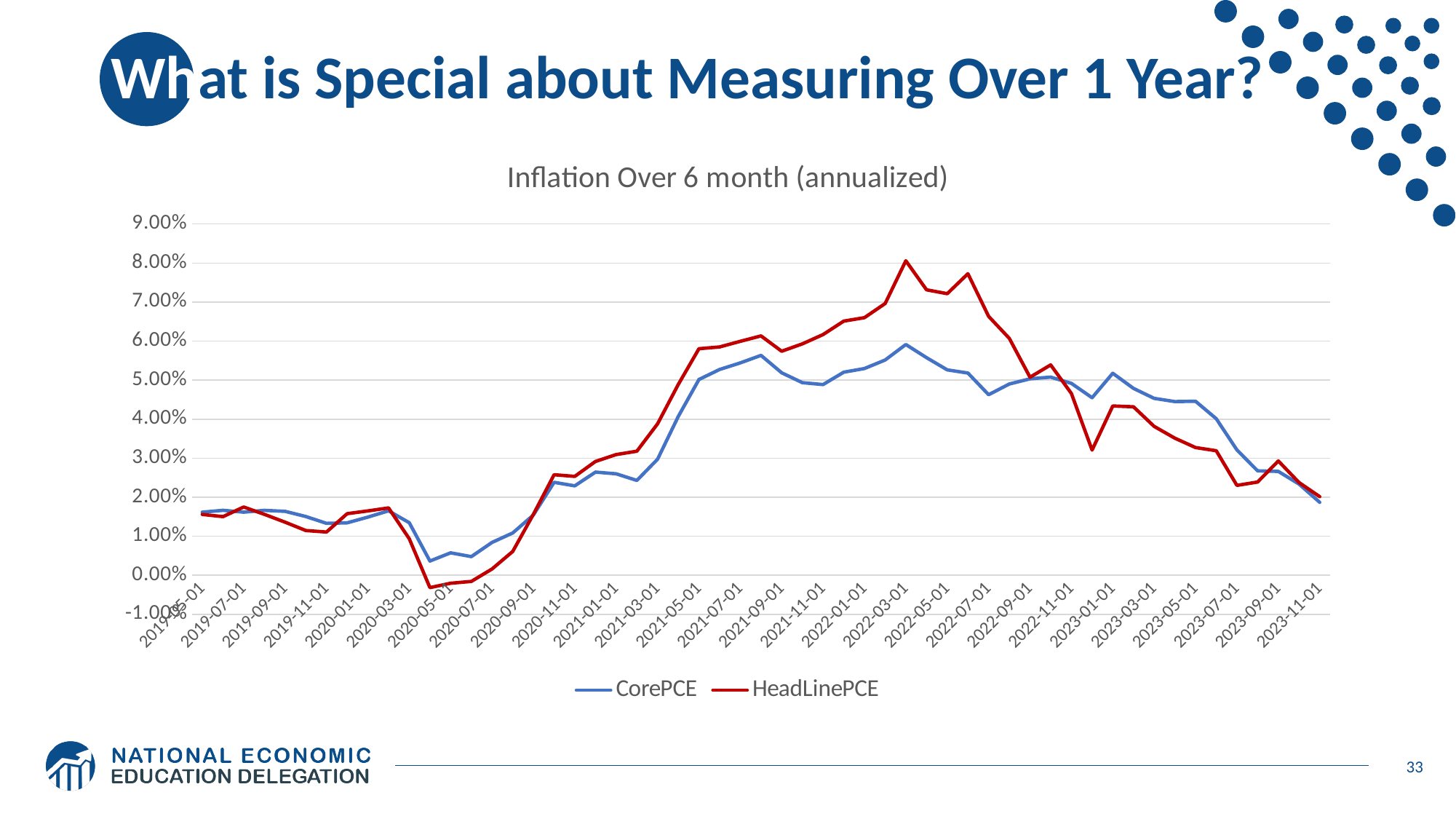
Which series reaches the highest value on the chart? HeadLinePCE Is the value for HeadLinePCE at 2022-03-01 greater or less than 7.00%? greater Which series has the larger value at 2023-01-01, CorePCE or HeadLinePCE? CorePCE Does the HeadLinePCE line rise or fall between 2020-05-01 and 2022-03-01? Rise How many series does the legend list? 2 What is the title of the chart? Inflation Over 6 month (annualized) How many date labels are shown on the x axis? 28 Which colour is used for the HeadLinePCE line? Red What kind of chart is shown on the slide? Line chart Is the value for HeadLinePCE at 2020-05-01 greater or less than 0.00%? less Which series has the larger value at 2021-05-01, CorePCE or HeadLinePCE? HeadLinePCE Is the value for CorePCE at 2022-03-01 greater or less than 7.00%? less